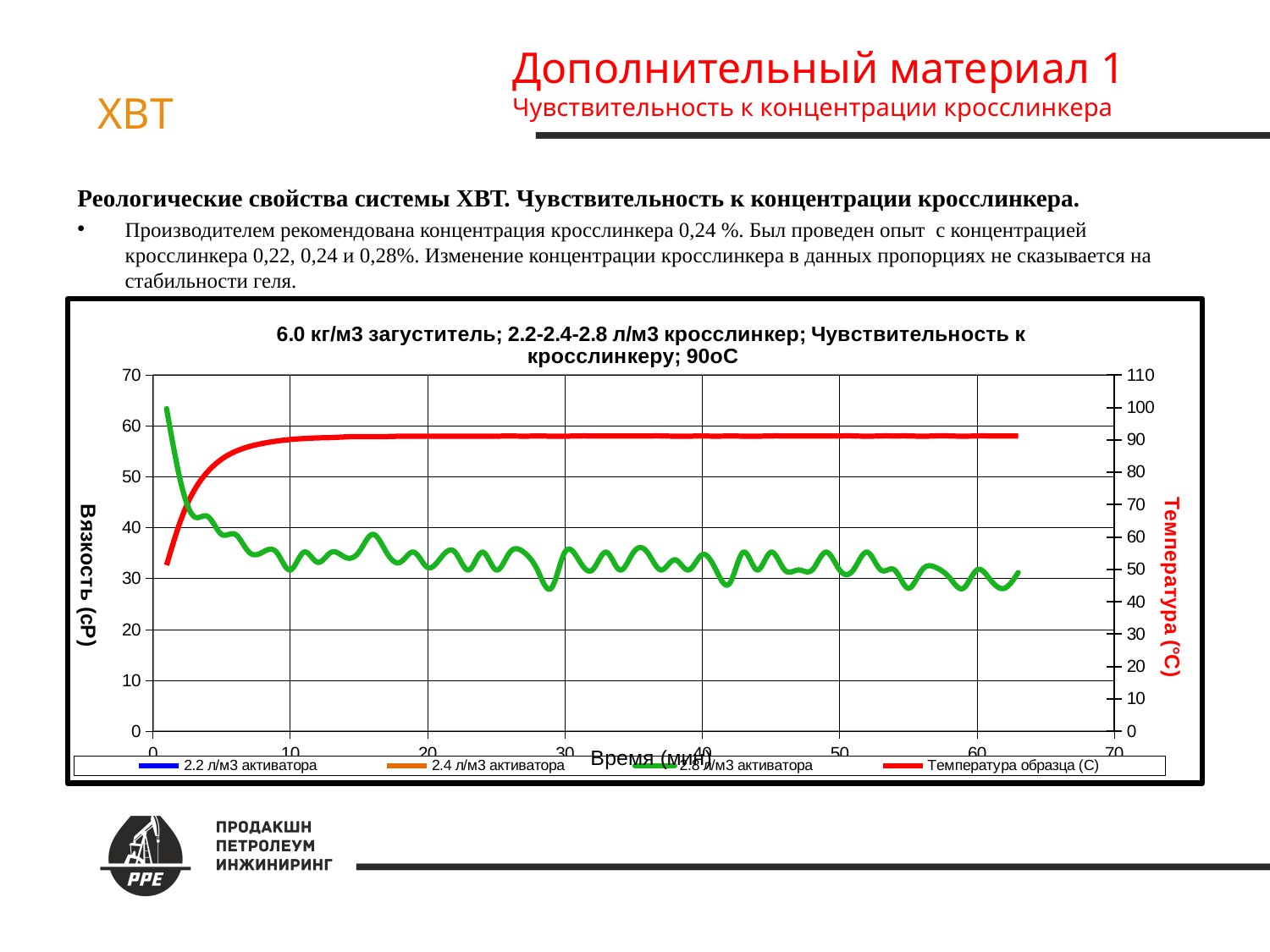
What is the maximum value shown on the right vertical axis of the chart? 110 What kind of chart is shown on the slide? line chart Is the value of Температура образца (С) at 60 minutes greater or less than 80 on the right axis? greater Does the Температура образца (С) series rise or fall during the first 10 minutes? rise What is the title of the right vertical axis of the chart? Температура (°C) Is the value of Температура образца (С) at 1 minute greater or less than 60 on the right axis? less Is the viscosity of the 2.8 л/м3 активатора series at 60 minutes greater or less than 40 сР? less Does the viscosity of the 2.8 л/м3 активатора series rise or fall over time along the x axis? fall What is the title of the left vertical axis of the chart? Вязкость (сР) How many series does the chart legend list? 4